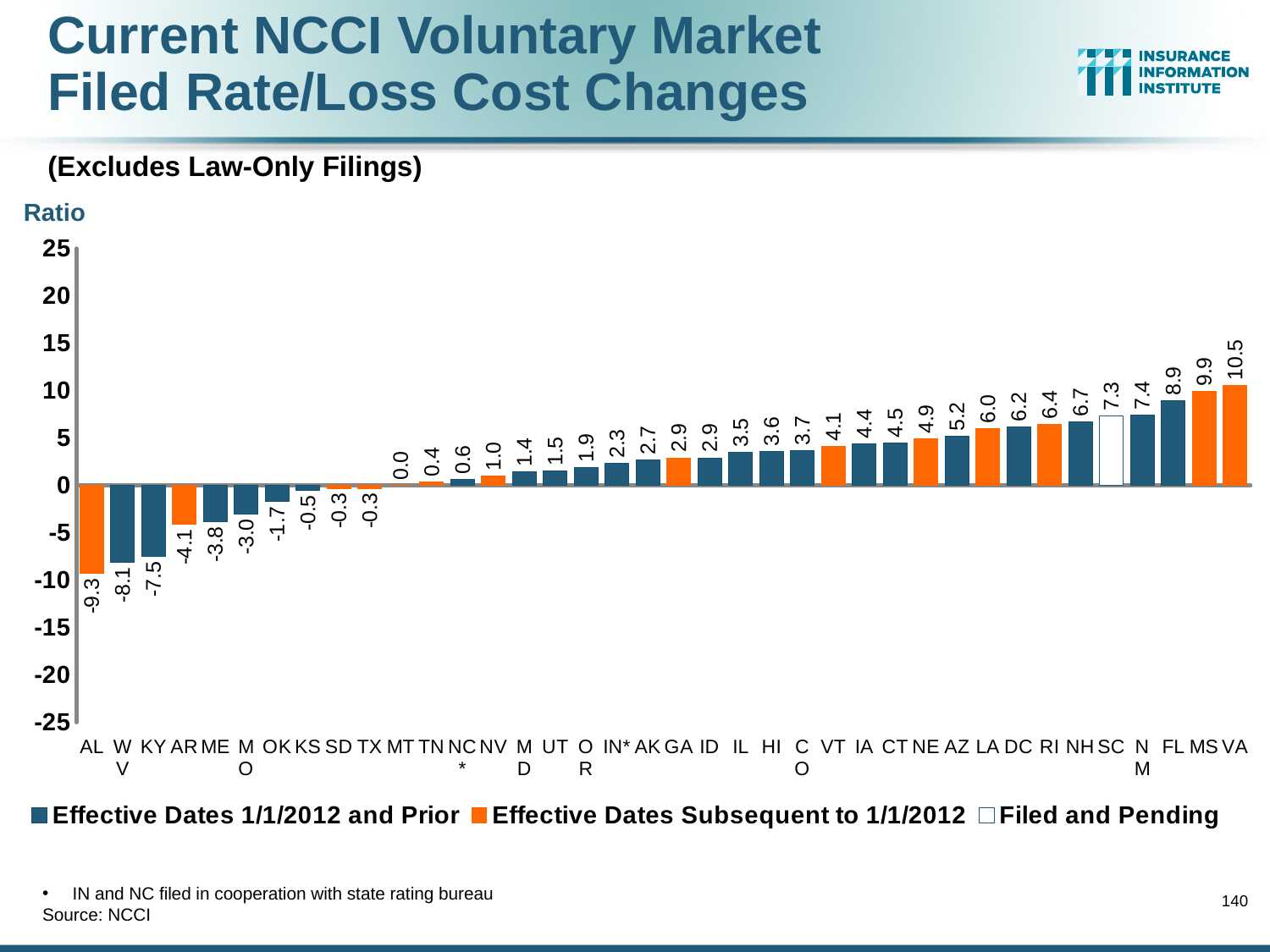
What is the value for VA? 10.5 What kind of chart is shown? Bar chart Which state has the lowest value? AL Which has the larger value, FL or MS? MS What is the value for SC? 7.3 How many states are shown on the chart? 38 Which state has the highest value? VA Which state is shown as Filed and Pending? SC What is the difference between the values for VA and AL? 19.8 Do the values rise or fall from left to right along the x axis? Rise How many series does the legend list? 3 What is the value for AL? -9.3